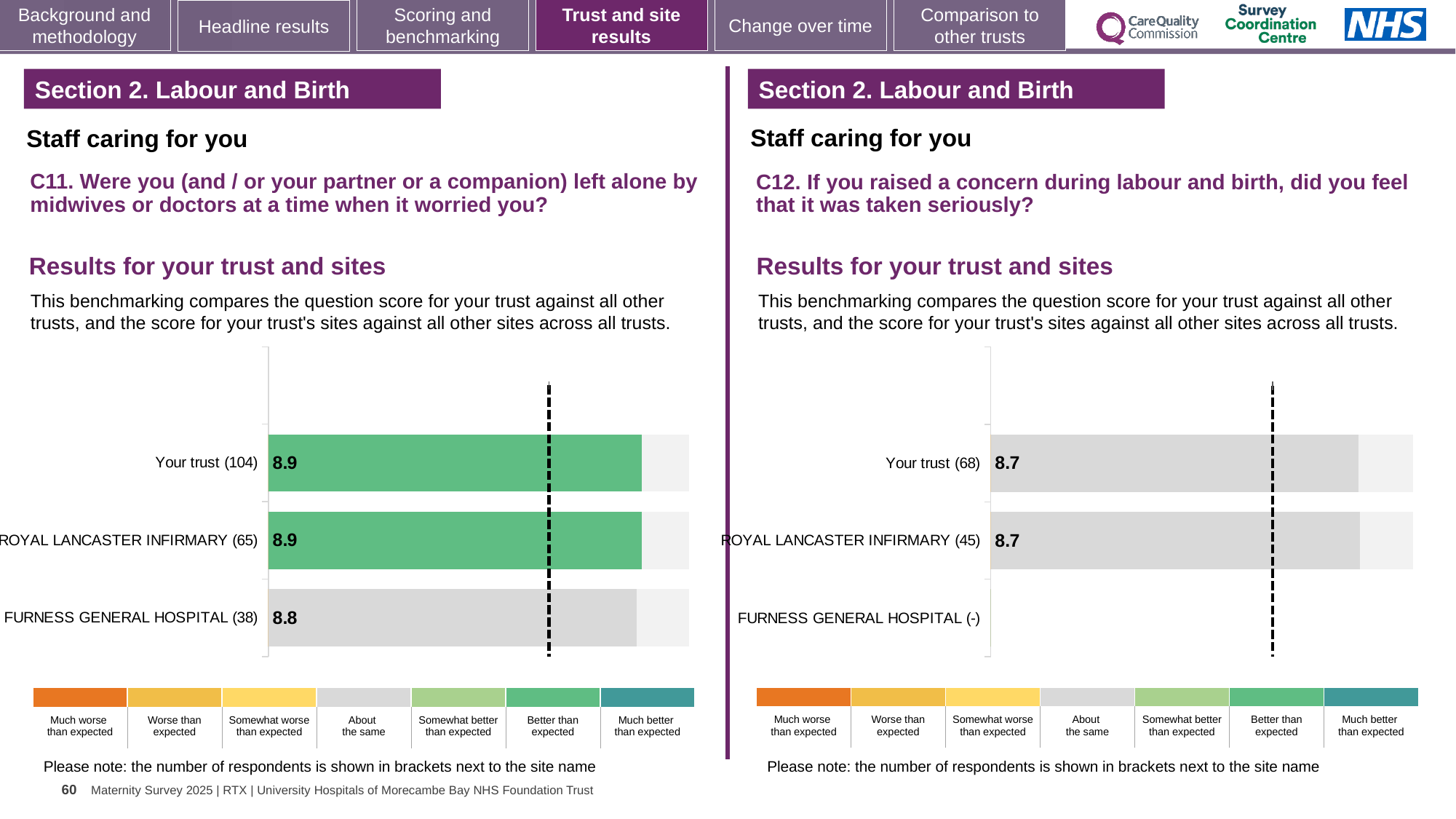
On the C11 chart (left), what is the score for Your trust? 8.9 On the C12 chart (right), what is the score for Royal Lancaster Infirmary? 8.7 What kind of chart is used on the C12 chart (right)? Bar chart On the C11 chart (left), what is the score for Furness General Hospital? 8.8 On the C11 chart (left), which site has the lowest score? Furness General Hospital On the C12 chart (right), how many respondents are shown in brackets for Royal Lancaster Infirmary? 45 On the C12 chart (right), what is the score for Your trust? 8.7 On the C11 chart (left), how many respondents are shown in brackets for Your trust? 104 On the C11 chart (left), what is the difference between the score for Your trust and the score for Furness General Hospital? 0.1 On the C11 chart (left), how many categories (trust and sites) are listed? 3 On the C11 chart (left), which benchmark category does the colour of the Your trust bar correspond to in the legend? Better than expected On the C11 chart (left), what is the score for Royal Lancaster Infirmary? 8.9